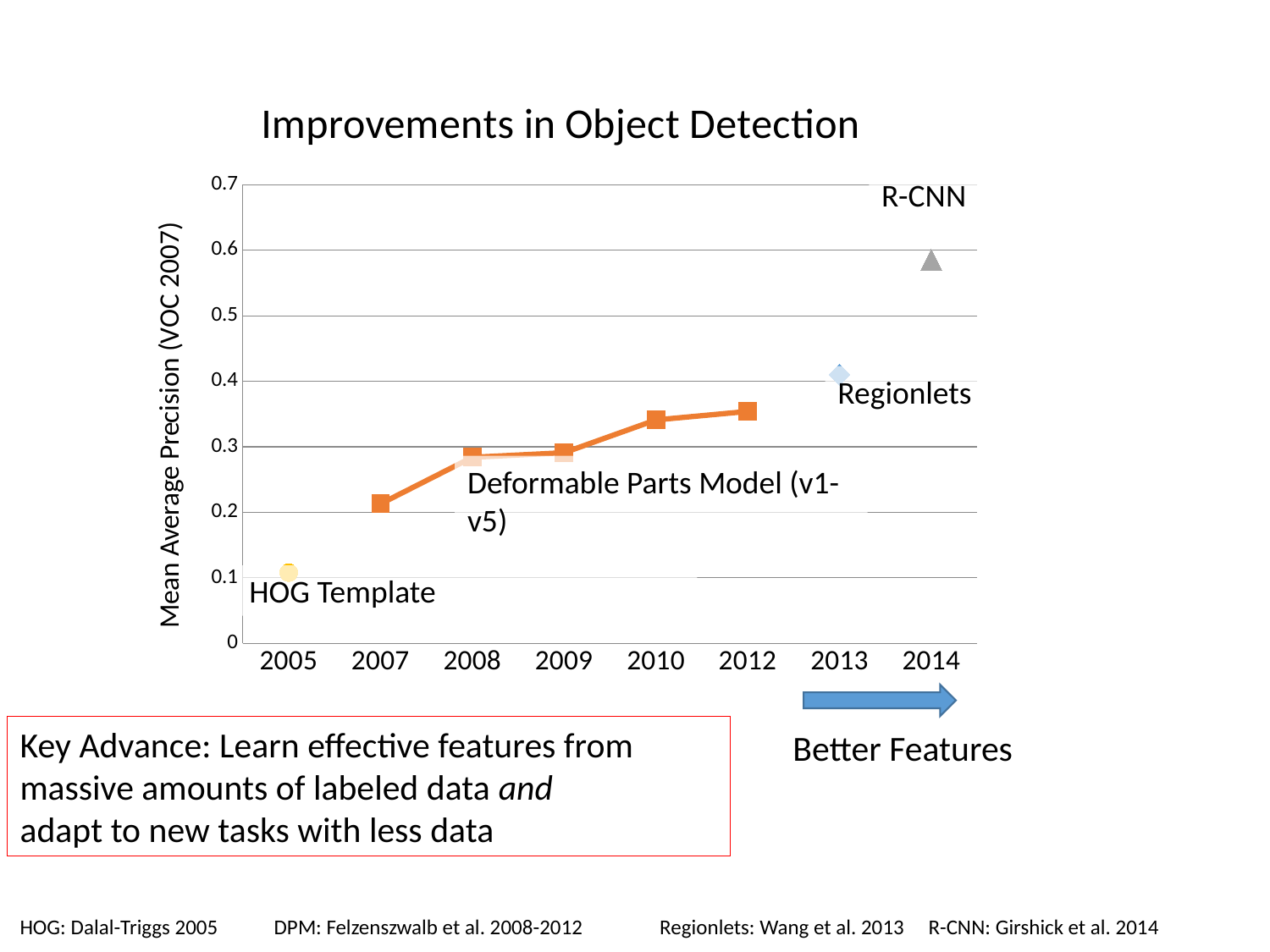
Which year has the lowest mean average precision? 2005 Is the value for R-CNN in 2014 greater or less than 0.5? greater How many years are shown on the x axis? 8 What is the title of the chart? Improvements in Object Detection Which is larger, the value for 2012 or the value for 2013? 2013 What kind of chart is shown on the slide? line chart Is the value for Regionlets in 2013 greater or less than 0.5? less Do the values generally rise or fall from 2005 to 2014? rise Which year has the highest mean average precision? 2014 Is the value for the HOG Template in 2005 greater or less than 0.2? less What is the label of the y axis? Mean Average Precision (VOC 2007)